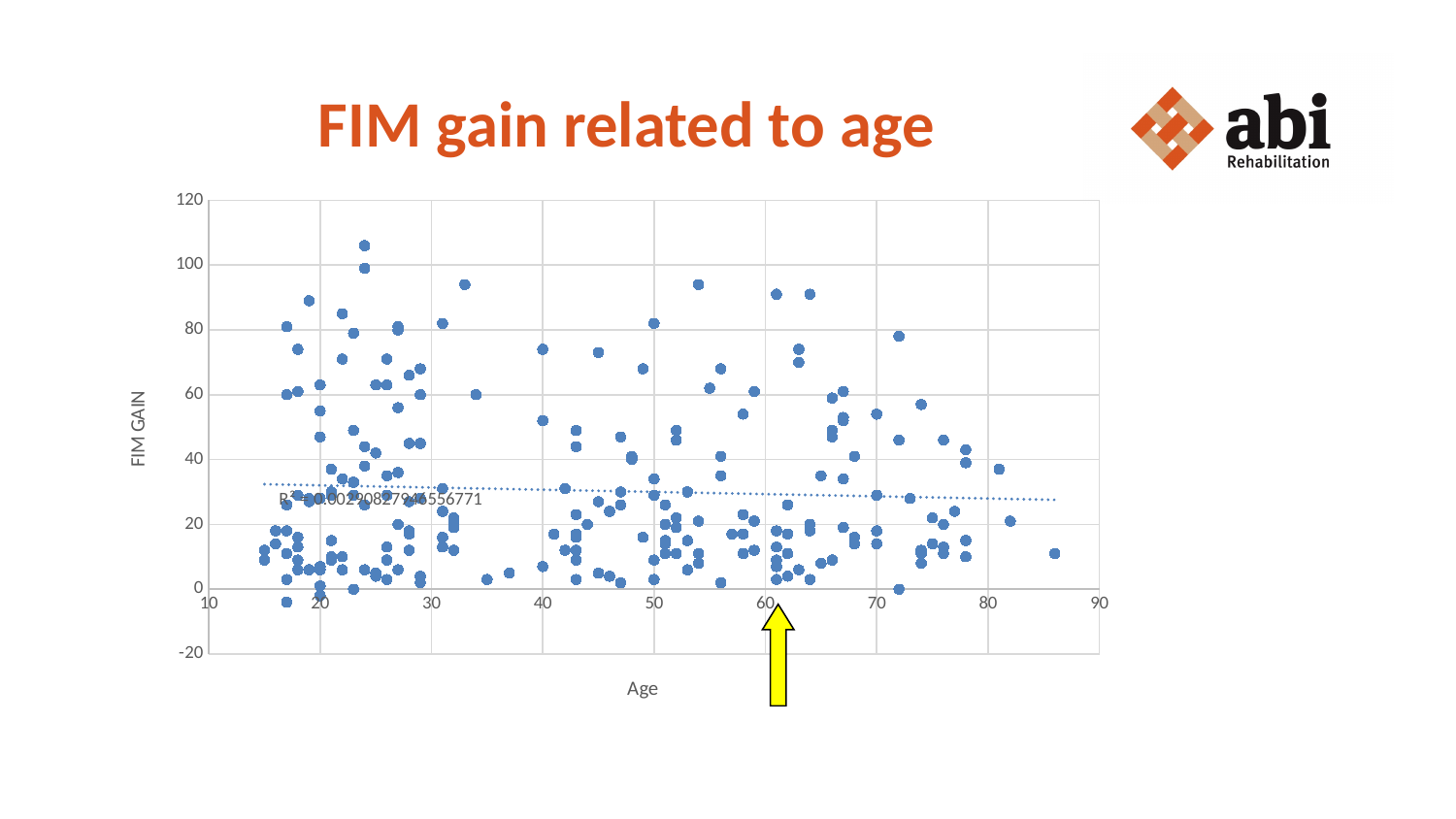
What is the title of the chart? FIM gain related to age Is the highest FIM gain value plotted greater or less than 100? greater Is the highest FIM gain value plotted greater or less than 120? less Is the lowest FIM gain value plotted greater or less than 20? less What is the label of the vertical axis of the chart? FIM GAIN Does the dotted trend line rise or fall as age increases along the x axis? Falls slightly What kind of chart is shown on the slide? Scatter plot